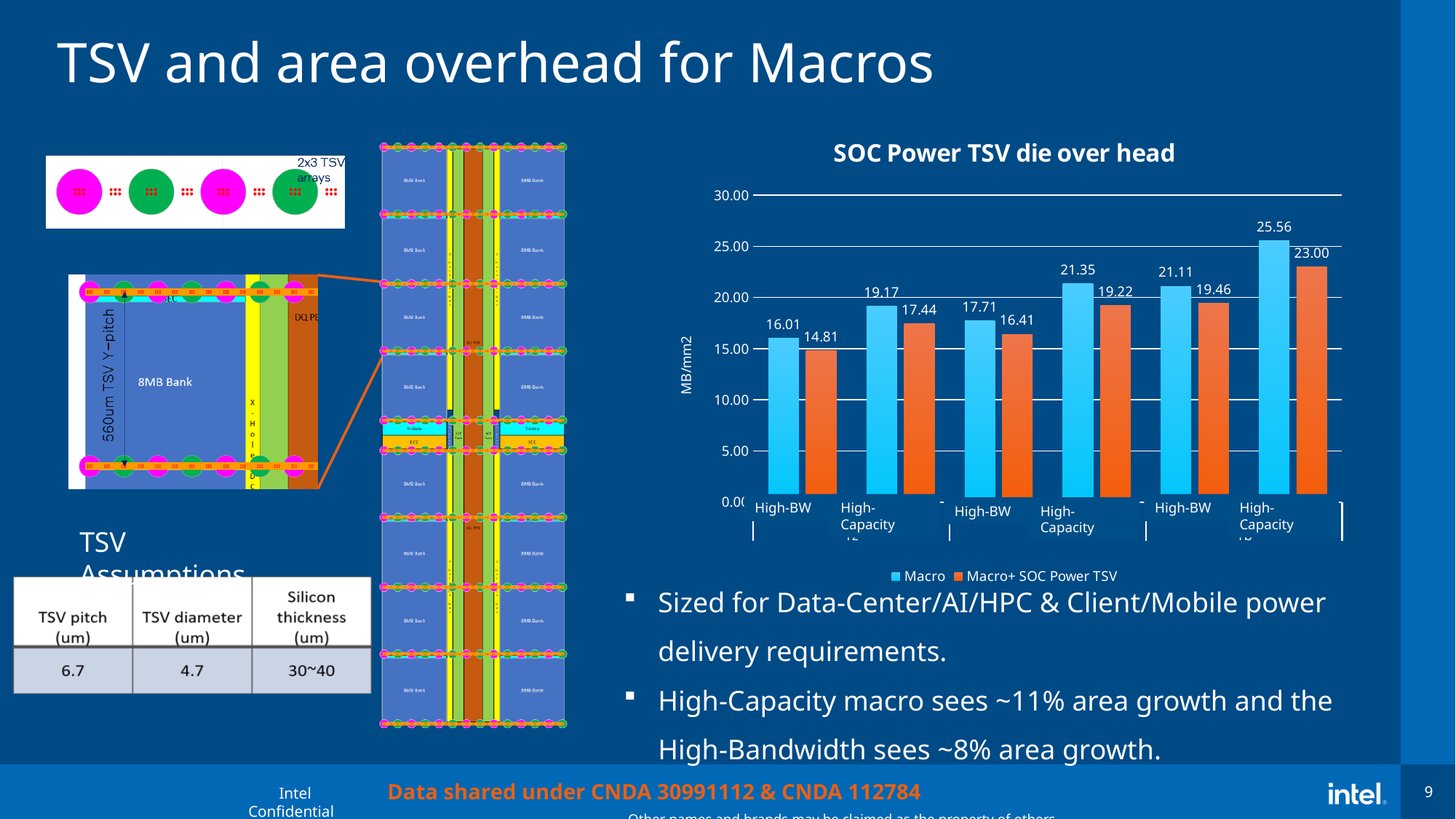
Which bar in the chart has the highest value? Macro for the rightmost High-Capacity (25.56) What is the Macro value for the rightmost High-Capacity category? 25.56 What is the Macro value for the leftmost High-BW category? 16.01 What type of chart is shown on the slide? bar chart How many series does the chart legend list? 2 What is the Macro+ SOC Power TSV value for the leftmost High-BW category? 14.81 Which bar in the chart has the lowest value? Macro+ SOC Power TSV for the leftmost High-BW (14.81) What is the title of the chart on the slide? SOC Power TSV die over head What is the Macro+ SOC Power TSV value for the rightmost High-Capacity category? 23.00 What unit is shown on the y-axis of the chart? MB/mm2 What is the difference between the Macro and Macro+ SOC Power TSV values for the rightmost High-Capacity category? 2.56 For the leftmost High-BW category, which is larger: the Macro value or the Macro+ SOC Power TSV value? Macro